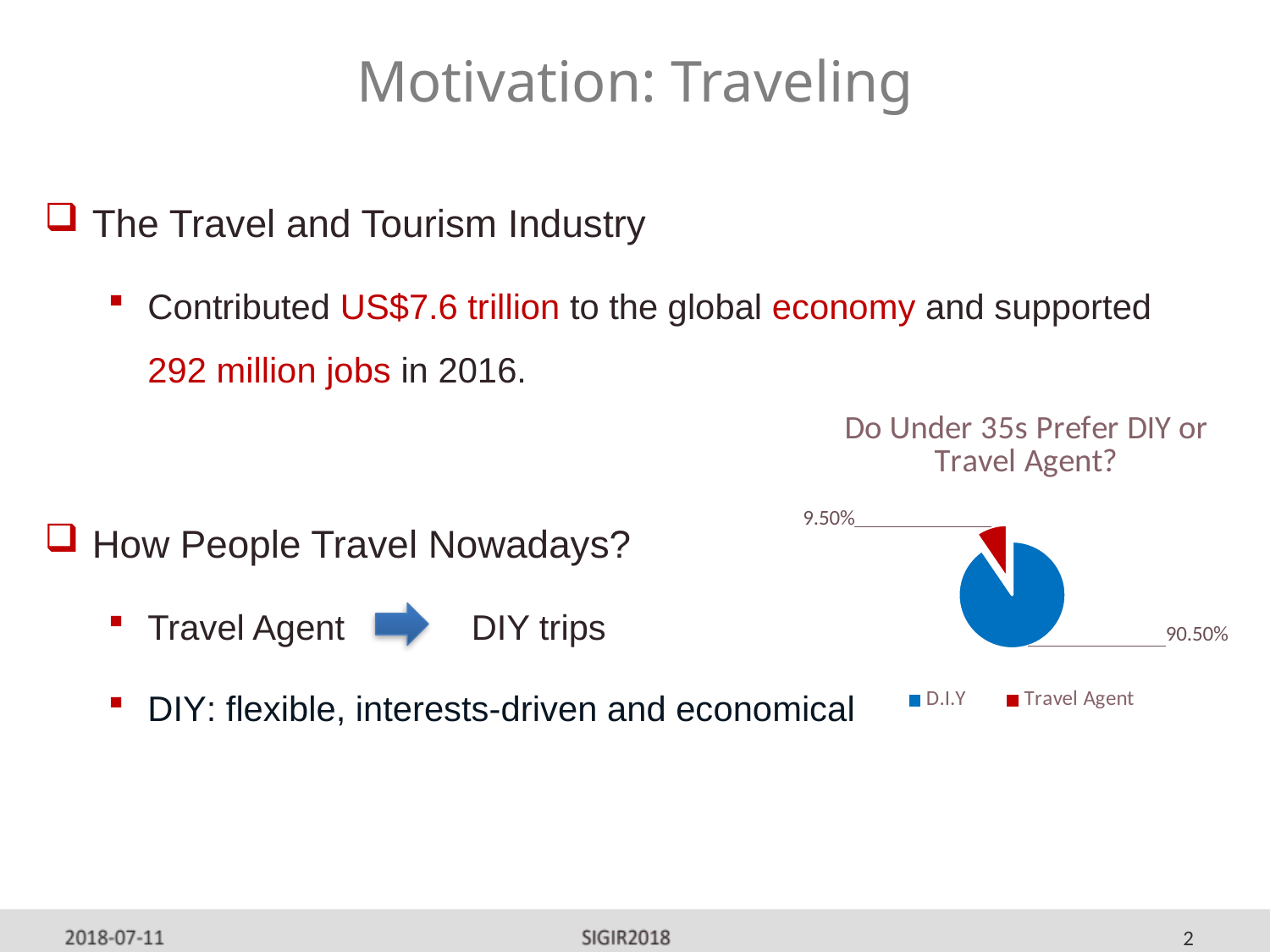
What kind of chart is shown on the slide? pie chart How many entries does the legend list? 2 What share of the pie does D.I.Y account for? 90.50% Which is larger, the D.I.Y slice or the Travel Agent slice? D.I.Y What is the title of the chart? Do Under 35s Prefer DIY or Travel Agent? How many categories does the pie chart show? 2 What is the difference in percentage points between the D.I.Y and Travel Agent slices? 81.00 percentage points What colour is the Travel Agent slice? red Which category has the largest slice of the pie? D.I.Y What share of the pie does Travel Agent account for? 9.50% Which category has the smallest slice of the pie? Travel Agent